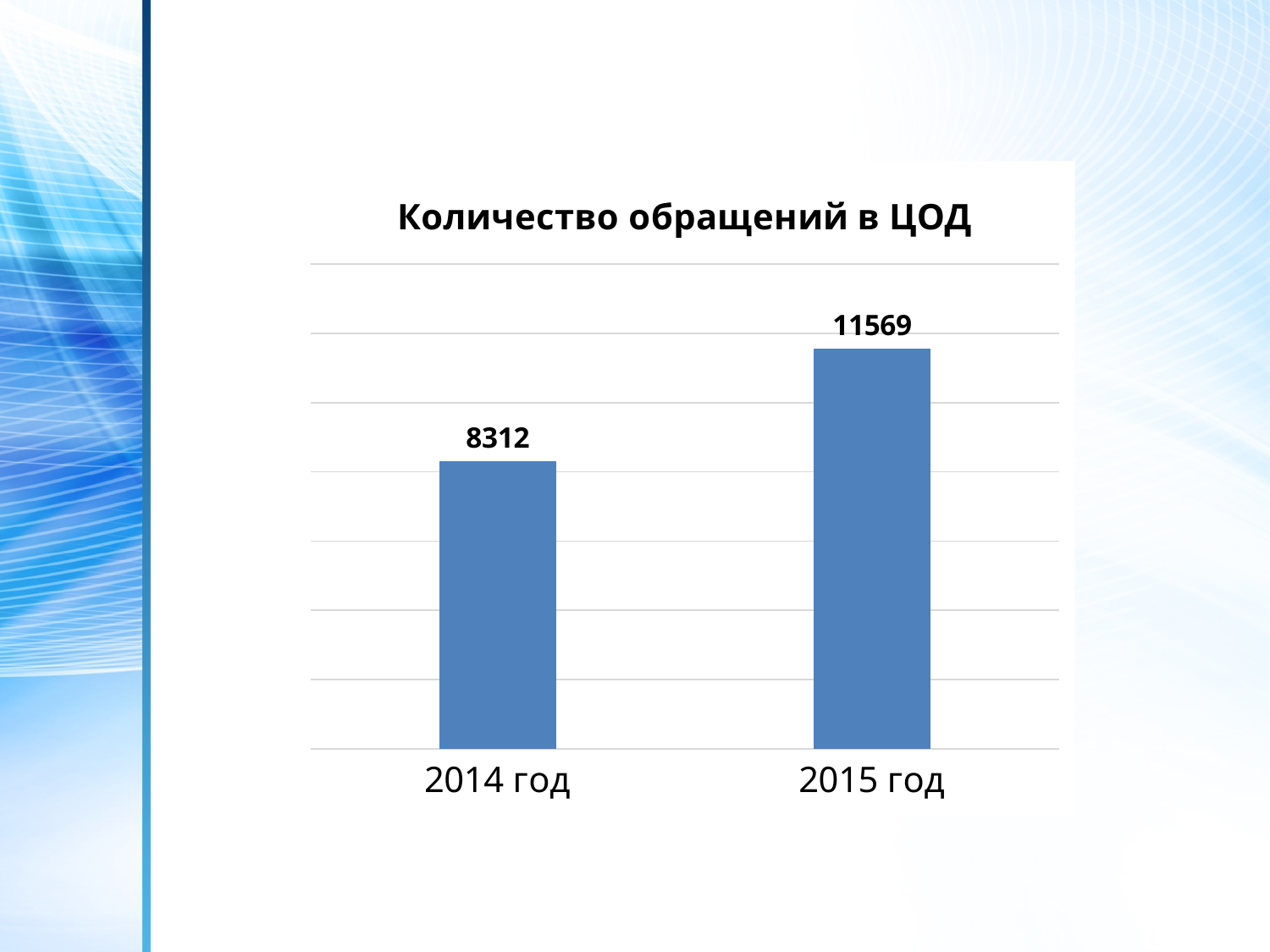
What is the difference between the values for 2015 год and 2014 год? 3257 Which is larger, the value for 2014 год or 2015 год? 2015 год Which year has the lowest value? 2014 год Do the values rise or fall from 2014 год to 2015 год? rise What is the title of the chart? Количество обращений в ЦОД What colour are the bars in the chart? blue Which year has the highest value? 2015 год What is the value for 2015 год? 11569 What is the total of the values for 2014 год and 2015 год? 19881 How many categories are shown on the chart? 2 What kind of chart is shown on the slide? bar chart What is the value for 2014 год? 8312